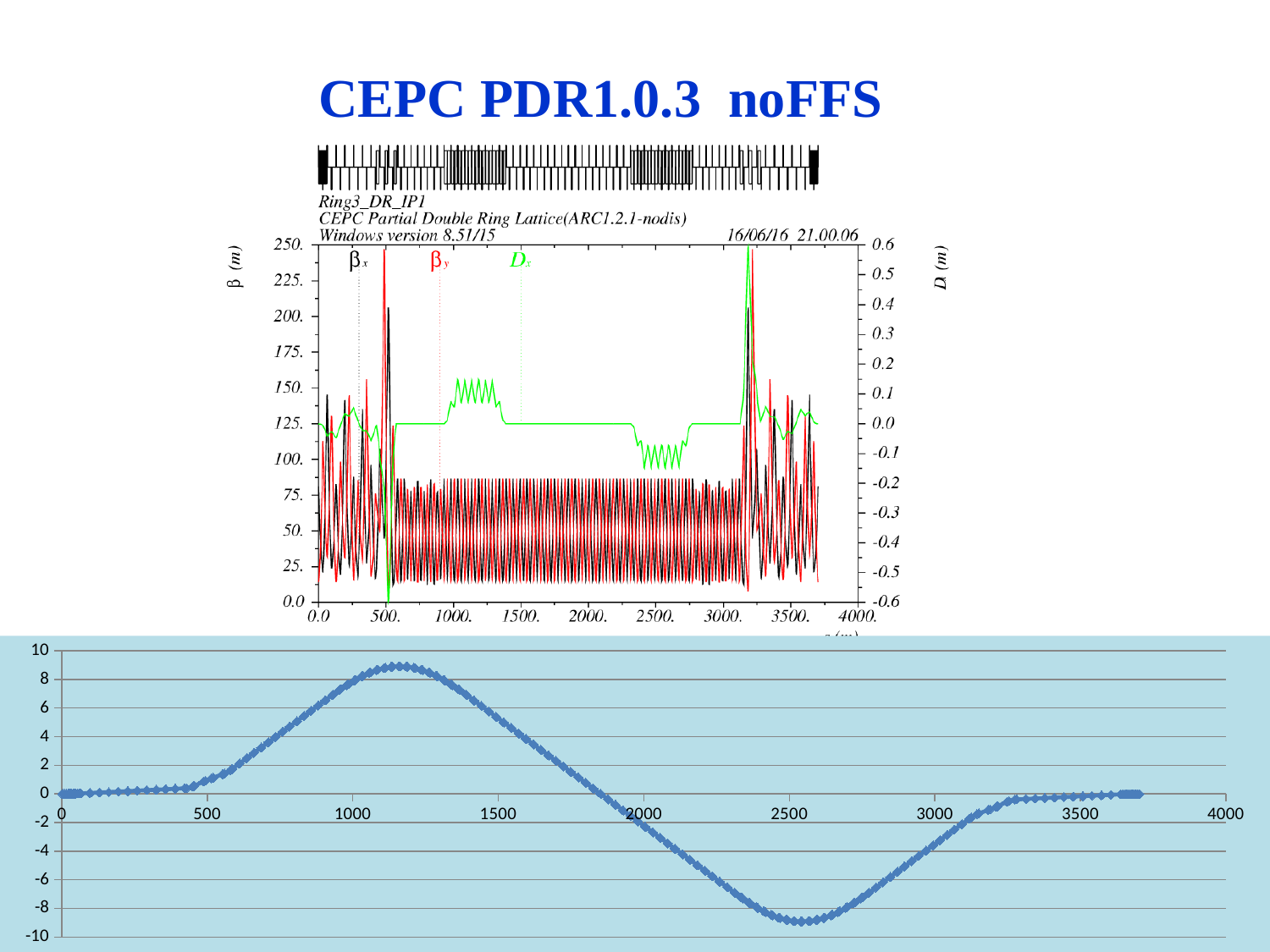
In the top chart, is the value of Dx at s = 2000 greater or less than 0.1? less In the top chart, is the value of Dx at s = 2500 greater or less than 0.0? less In the bottom chart, do the values rise or fall as x goes from 1200 to 2500? fall In the bottom chart, is the value at x = 1150 greater or less than 8? greater In the top chart, which series is drawn in green? Dx What kind of chart is the top chart on the slide? line chart How many series does the legend of the top chart list? 3 What kind of chart is the bottom chart on the slide? line chart What is the maximum value shown on the left vertical axis of the top chart? 250.